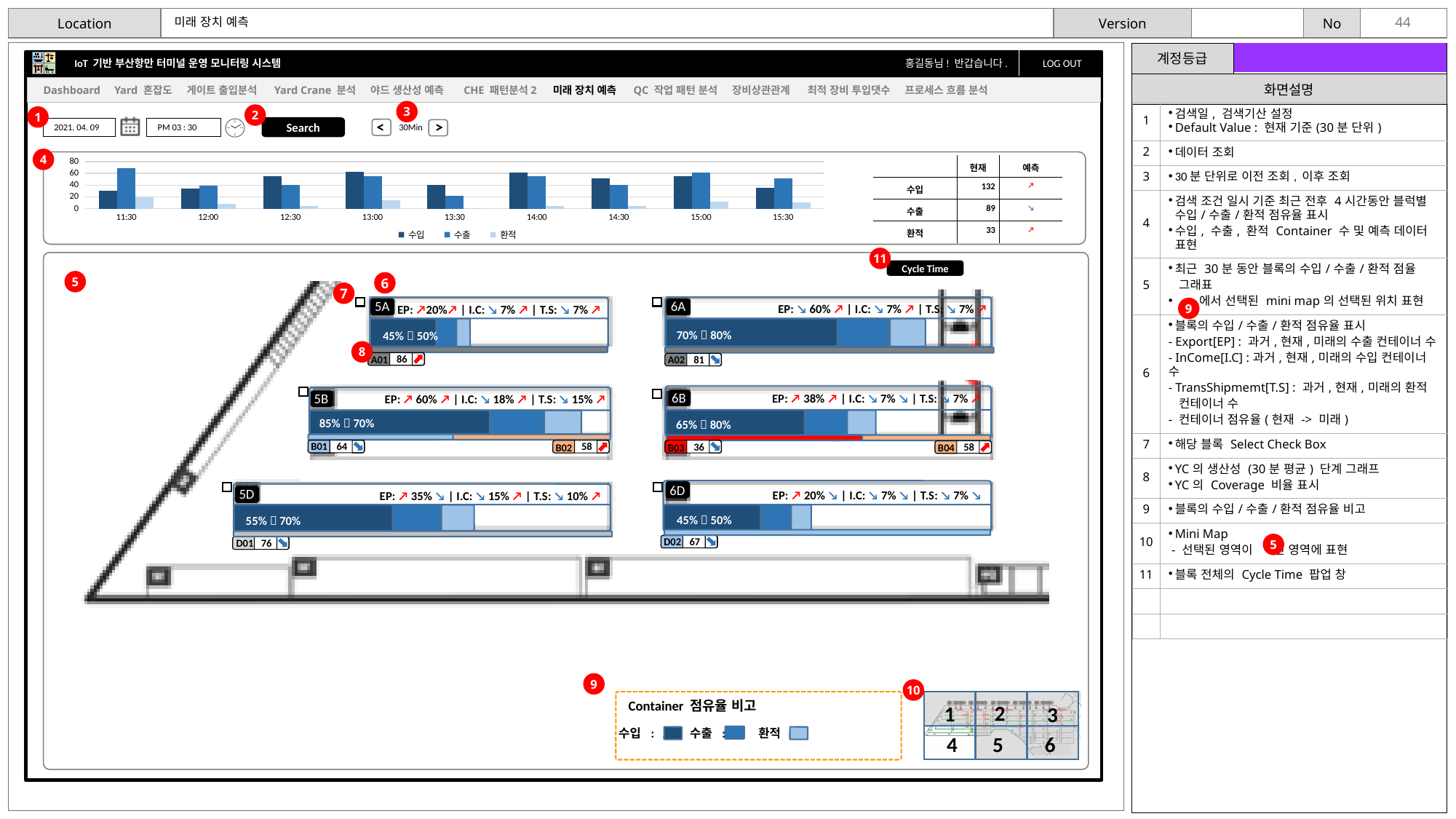
In the top bar chart, is the value for 수출 at 13:30 greater or less than 40? less In the top bar chart, is the value for 환적 at 12:30 greater or less than 20? less How many series does the legend of the top bar chart list? 3 How many time categories are shown on the x axis of the top bar chart? 9 In the top bar chart, is the value for 수입 at 13:00 greater or less than 40? greater In the top bar chart, at 11:30, which is larger: 수입 or 수출? 수출 In the top bar chart, at 13:30, which is larger: 수입 or 수출? 수입 In the top bar chart, which series does the legend list first? 수입 In the top bar chart, at which time is the 수출 value lowest? 13:30 What kind of chart is shown in the top panel with the time axis from 11:30 to 15:30? bar chart